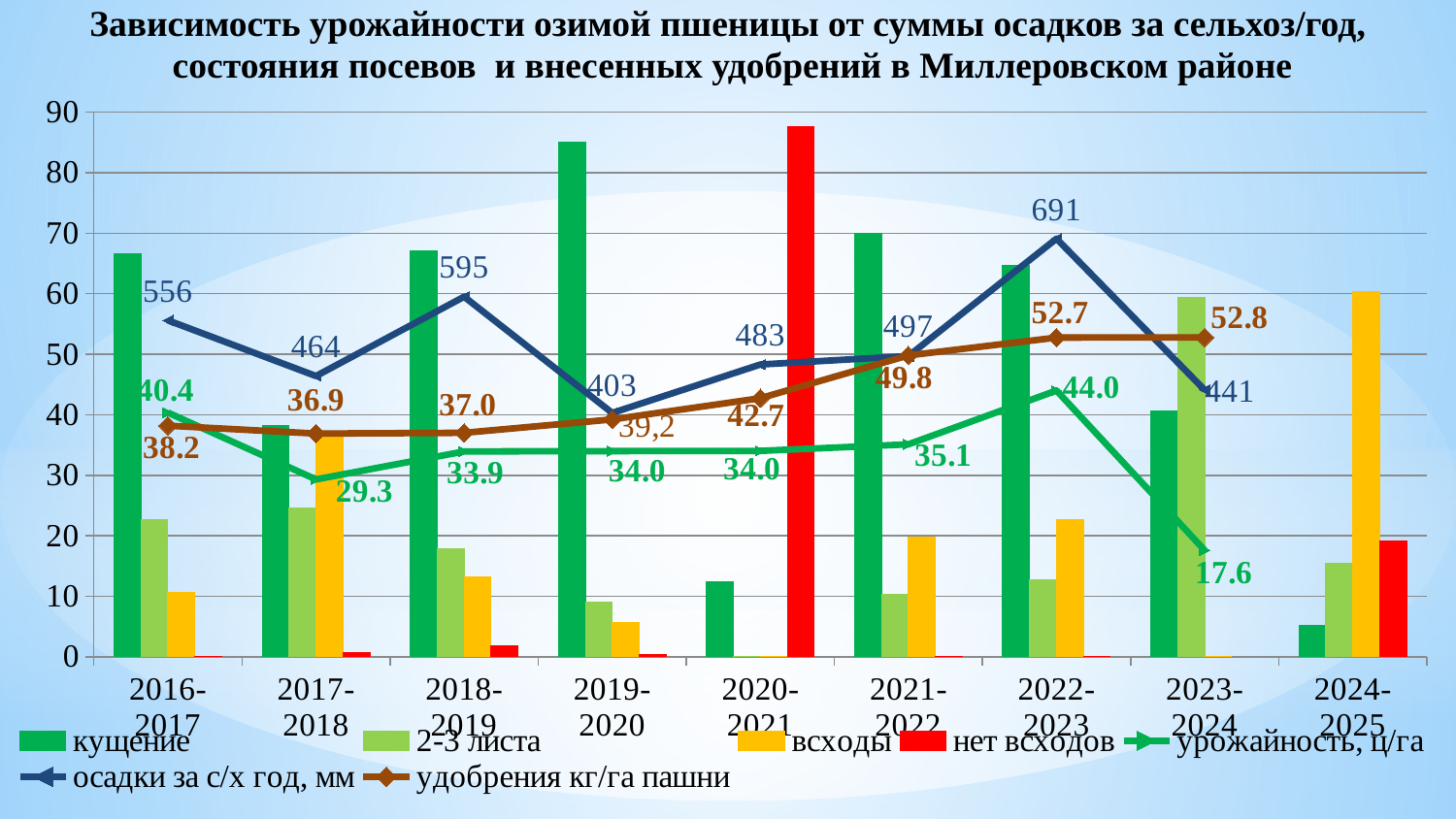
What is the value of осадки за с/х год, мм for 2022-2023? 691 Which season has the larger осадки за с/х год, мм value: 2016-2017 or 2017-2018? 2016-2017 Does the удобрения кг/га пашни line generally rise or fall from 2016-2017 to 2023-2024? rise How many seasons are shown on the x axis? 9 In which season is осадки за с/х год, мм the lowest? 2019-2020 What is the урожайность, ц/га value for 2023-2024? 17.6 How many series does the legend list? 7 What is the difference between the highest and lowest осадки за с/х год, мм values (691 and 403)? 288 What is the удобрения кг/га пашни value for 2020-2021? 42.7 In which season is урожайность, ц/га the lowest? 2023-2024 In which season is осадки за с/х год, мм the highest? 2022-2023 Is the кущение bar for 2019-2020 greater or less than 80? greater